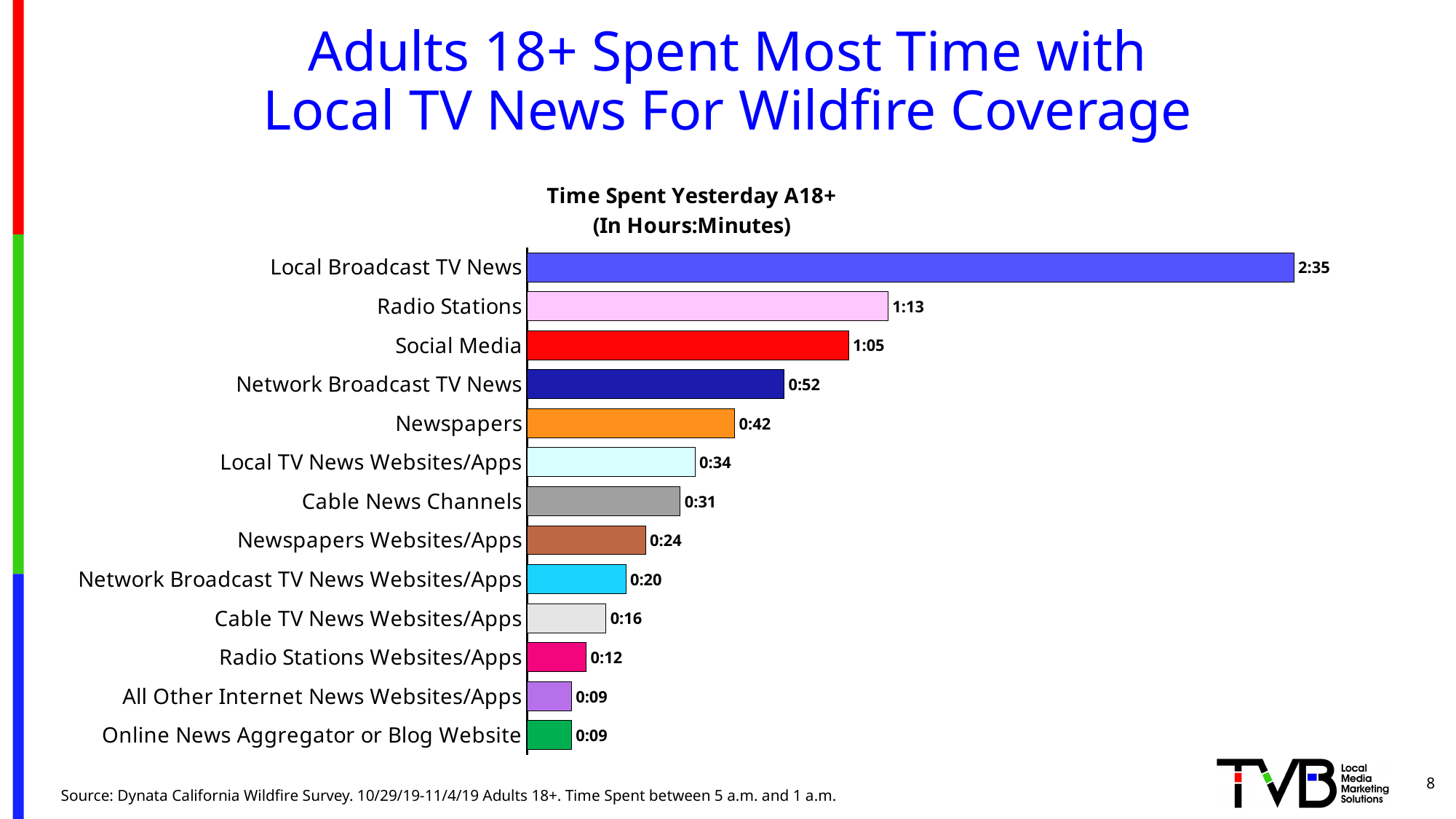
How many categories are shown in the chart? 13 Which has a larger time spent, Newspapers or Newspapers Websites/Apps? Newspapers What is the difference in time spent between Local Broadcast TV News and Radio Stations? 1:22 What is the time spent yesterday with Radio Stations Websites/Apps? 0:12 What is the title of the chart? Time Spent Yesterday A18+ (In Hours:Minutes) Which category has the highest time spent? Local Broadcast TV News Which has a larger time spent, Radio Stations or Network Broadcast TV News? Radio Stations What is the time spent yesterday with Local Broadcast TV News? 2:35 What kind of chart is shown on the slide? bar chart What is the time spent yesterday with Cable News Channels? 0:31 What is the difference in time spent between Newspapers and Cable News Channels? 0:11 What is the time spent yesterday with Social Media? 1:05